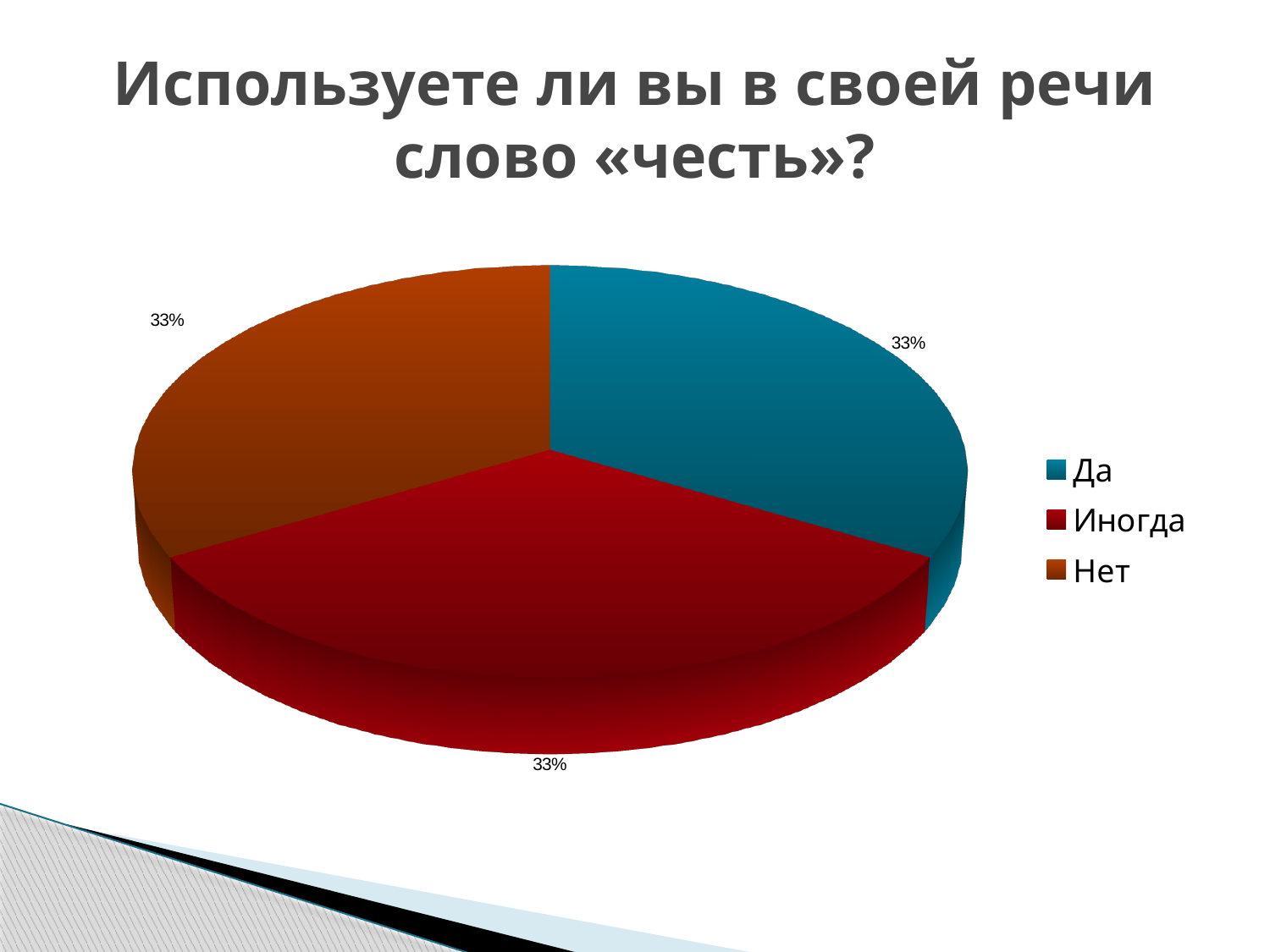
How many slices does the pie chart have? 3 What share of the pie does the "Да" slice represent? 33% What type of chart is shown on the slide? Pie chart Which colour represents the "Иногда" category in the pie chart? Red What is the value shown for the "Да" category? 33% How many entries does the legend list? 3 What is the value shown for the "Нет" category? 33% What is the title of the chart on the slide? Используете ли вы в своей речи слово «честь»? What share of the pie does the "Нет" slice represent? 33% Is the value for "Иногда" greater or less than 50%? less What share of the pie does the "Иногда" slice represent? 33%